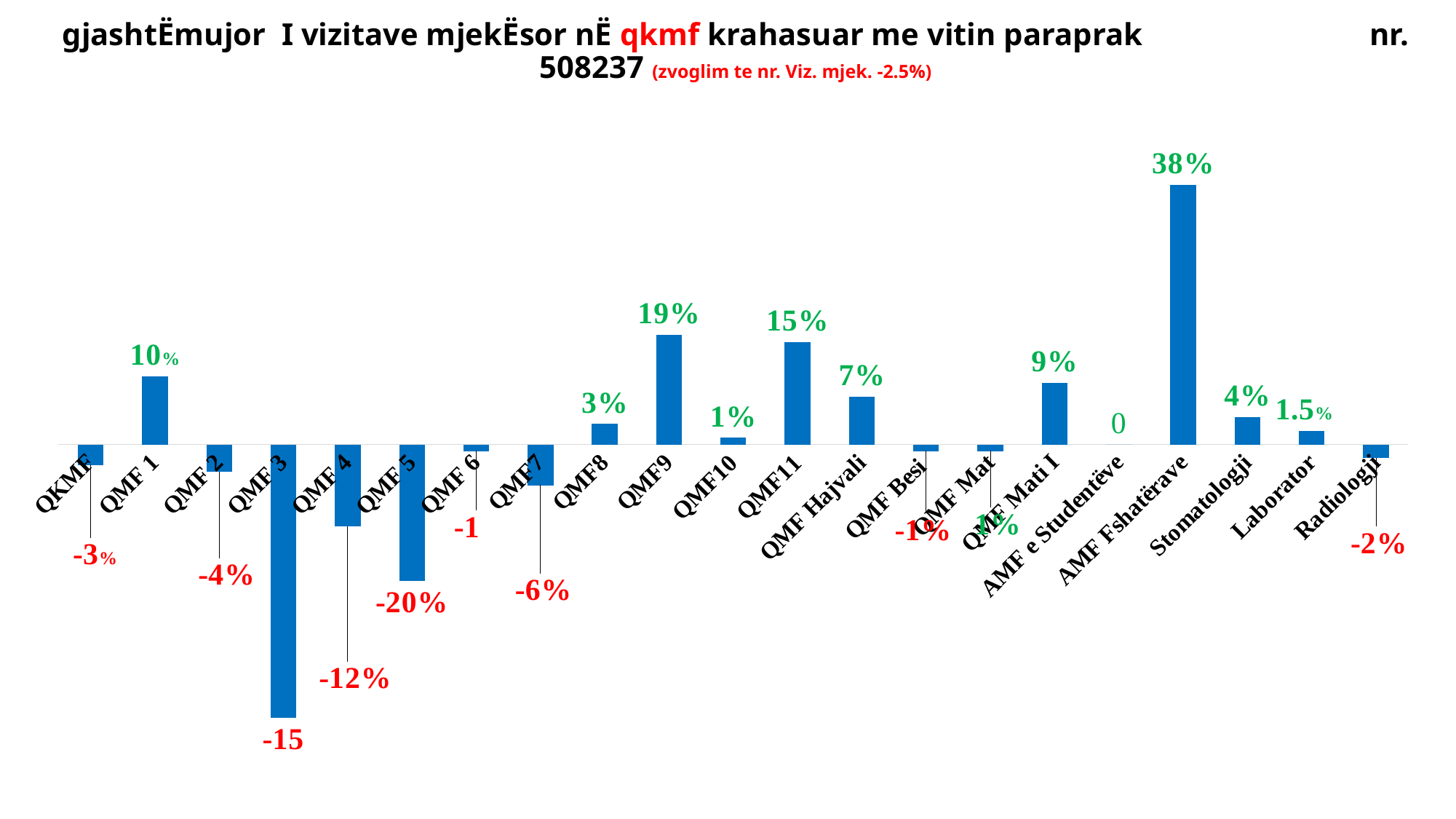
What is the value shown for Laborator? 1.5% What is the value shown for QMF 1? 10% What kind of chart is shown on the slide? bar chart Which category has the highest value? AMF Fshatërave What is the difference between the values for QMF 9 and QMF 11? 4 percentage points How many categories are shown on the x axis? 21 What percentage change is stated in the subtitle next to the number 508237? -2.5% What is the value shown for AMF Fshatërave? 38% Which is larger, the value for QMF 9 or the value for QMF 11? QMF 9 What is the value shown for AMF e Studentëve? 0 What is the value shown for QMF 5? -20% What is the value shown for QMF 9? 19%